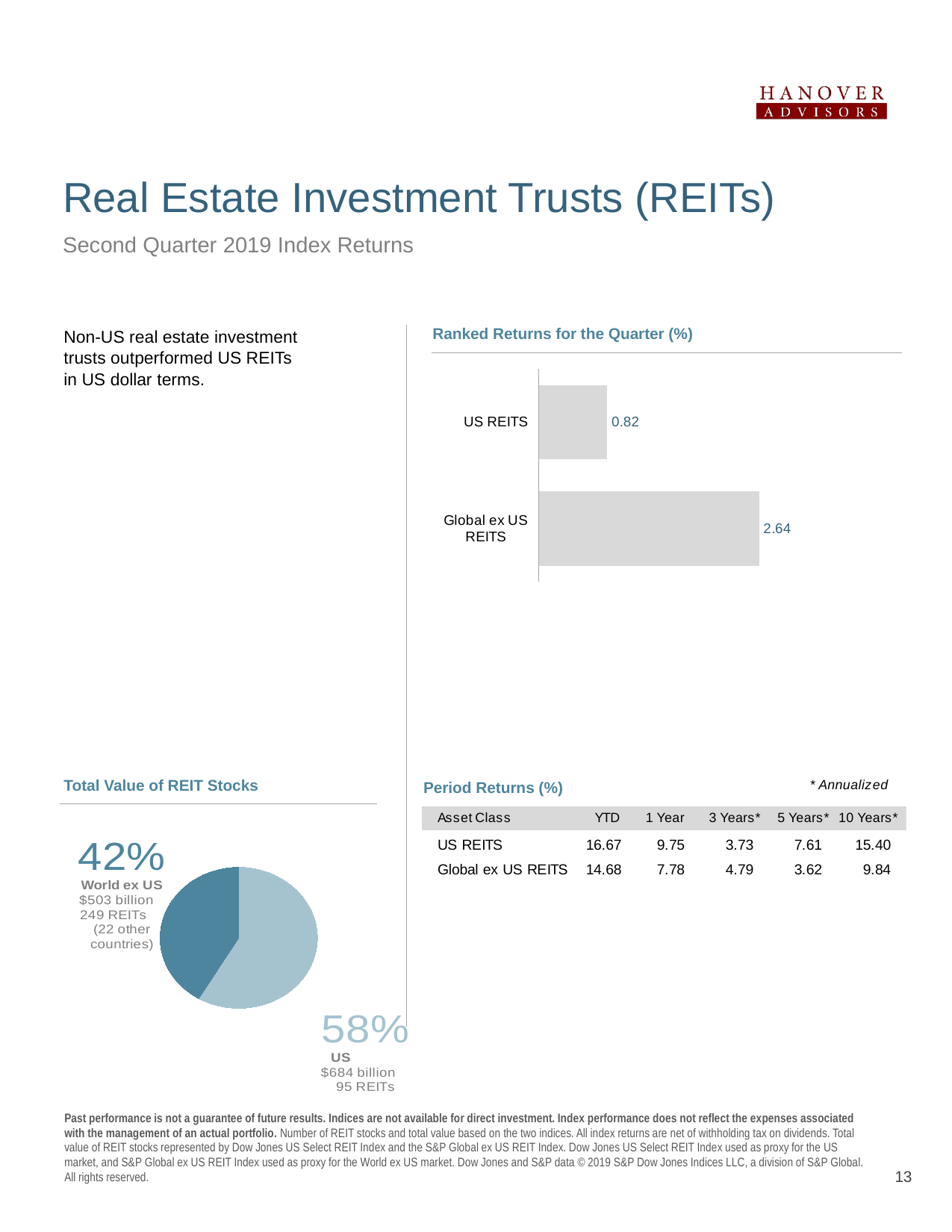
What kind of chart is the 'Total Value of REIT Stocks' chart? Pie chart In the 'Ranked Returns for the Quarter (%)' chart, what is the value for Global ex US REITS? 2.64 In the 'Ranked Returns for the Quarter (%)' chart, how many categories are plotted? 2 In the 'Ranked Returns for the Quarter (%)' chart, which category has the highest value? Global ex US REITS In the 'Total Value of REIT Stocks' chart, which slice is larger, US or World ex US? US In the 'Ranked Returns for the Quarter (%)' chart, which category has the lowest value? US REITS In the 'Ranked Returns for the Quarter (%)' chart, what is the difference between the Global ex US REITS value and the US REITS value? 1.82 In the 'Total Value of REIT Stocks' chart, what share of the pie is US? 58% What kind of chart is the 'Ranked Returns for the Quarter (%)' chart? Bar chart In the 'Ranked Returns for the Quarter (%)' chart, what is the value for US REITS? 0.82 In the 'Total Value of REIT Stocks' chart, what is the total value shown for the US slice? $684 billion In the 'Total Value of REIT Stocks' chart, what share of the pie is World ex US? 42%